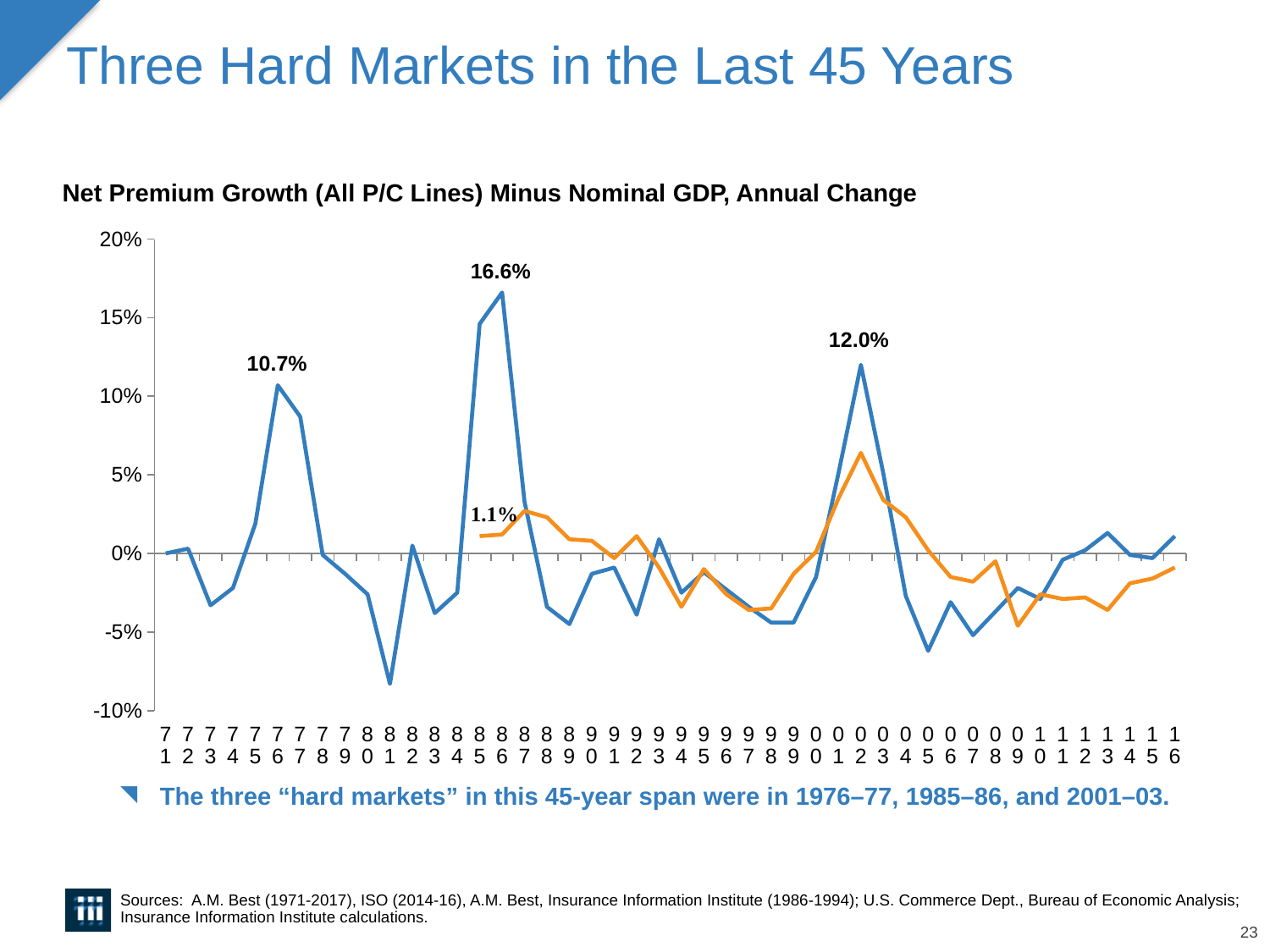
What value is labeled on the orange line in 1985? 1.1% What is the chart's title? Net Premium Growth (All P/C Lines) Minus Nominal GDP, Annual Change What is the labeled peak value of the blue line in 2002? 12.0% What kind of chart is shown on the slide? line chart In which year does the blue line reach its highest value? 86 What is the labeled peak value of the blue line in 1986? 16.6% What is the labeled peak value of the blue line in 1976? 10.7% In which year does the blue line reach its lowest value? 81 How many years are shown along the x axis? 46 What is the difference between the 1986 peak (16.6%) and the 2002 peak (12.0%)? 4.6% Is the value of the blue line in 1981 greater or less than -5%? less Which labeled peak is larger, 1976 or 2002? 2002